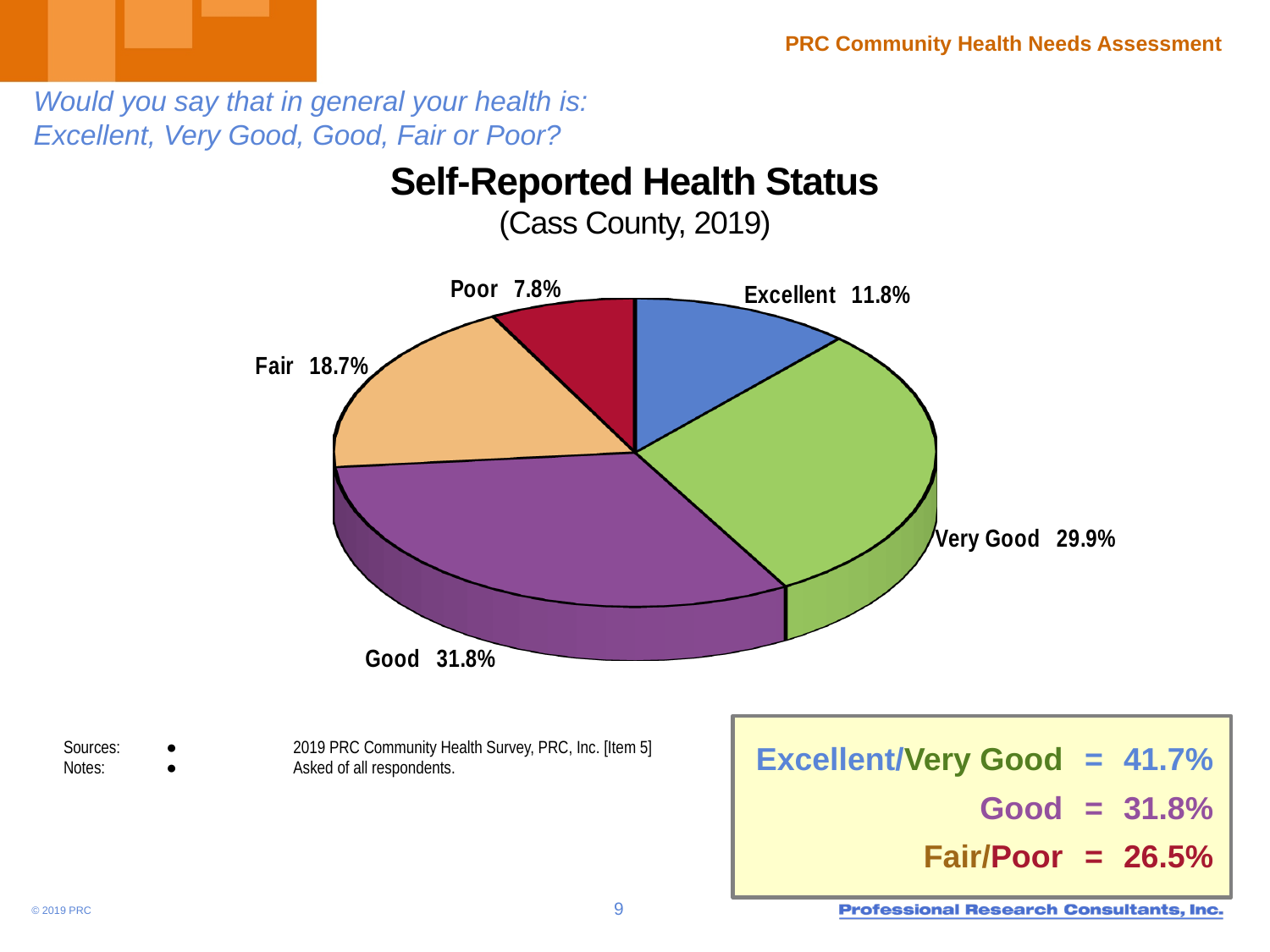
What percentage of respondents reported their health as Good? 31.8% What percentage of respondents reported their health as Poor? 7.8% What percentage of respondents reported their health as Excellent? 11.8% How many categories are shown in the pie chart? 5 Which health status category has the smallest share of the pie? Poor What is the title of the chart? Self-Reported Health Status What percentage of respondents reported their health as Fair? 18.7% What is the difference in percentage points between Very Good and Excellent? 18.1 Which is larger, the share for Fair or the share for Poor? Fair Which health status category has the largest share of the pie? Good What type of chart is shown on the slide? Pie chart What is the combined share of Excellent and Very Good? 41.7%